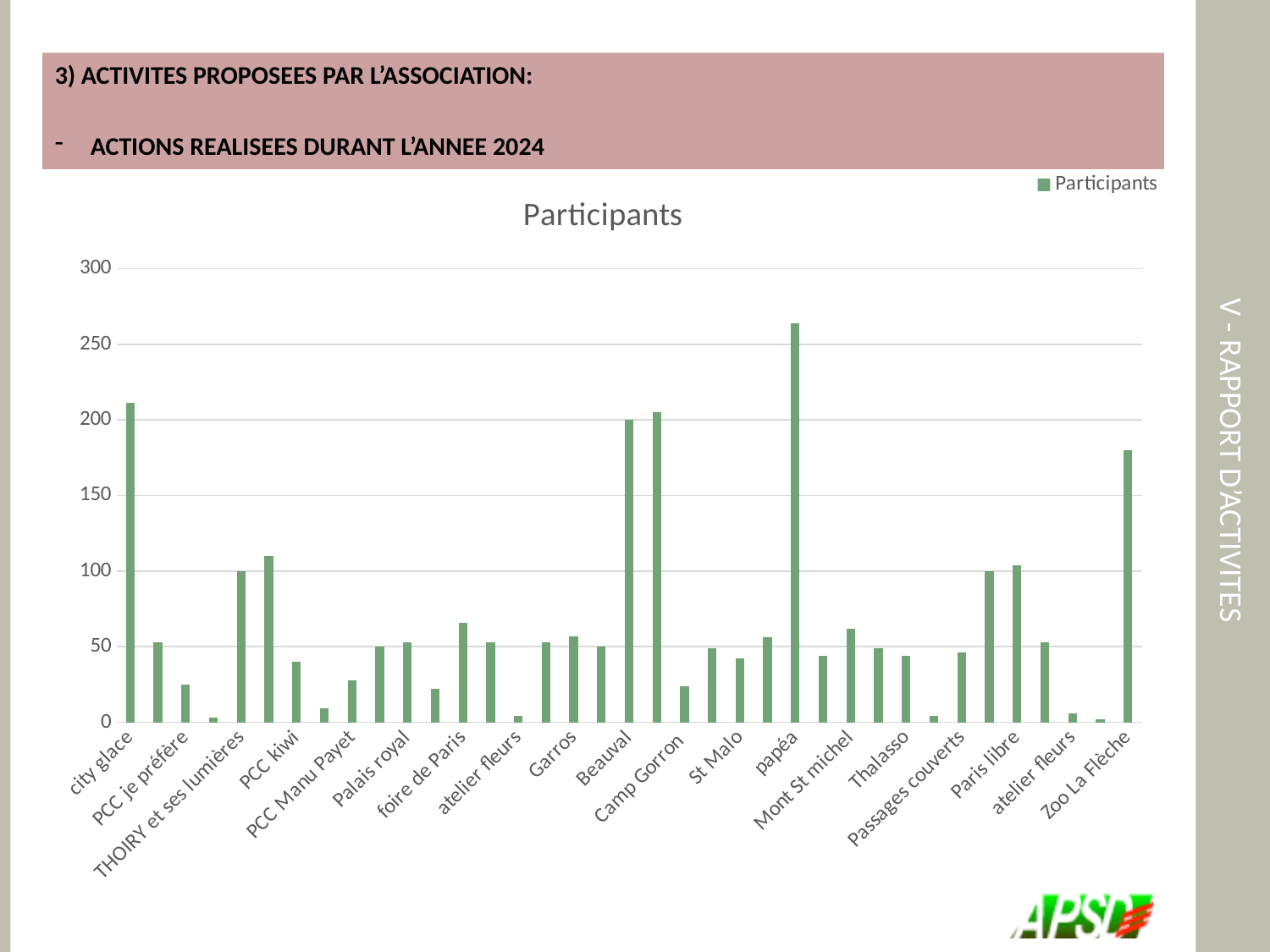
What kind of chart is shown on the slide? bar chart Is the value for city glace greater or less than 200? greater Is the value for papéa greater or less than 250? greater Is the value for Mont St michel greater or less than 50? greater Which has more participants, St Malo or Camp Gorron? St Malo Which category has the highest number of participants? papéa What is the title of the chart? Participants How many series does the chart legend list? 1 Which has more participants, Garros or atelier fleurs? Garros Which has more participants, Zoo La Flèche or Beauval? Beauval